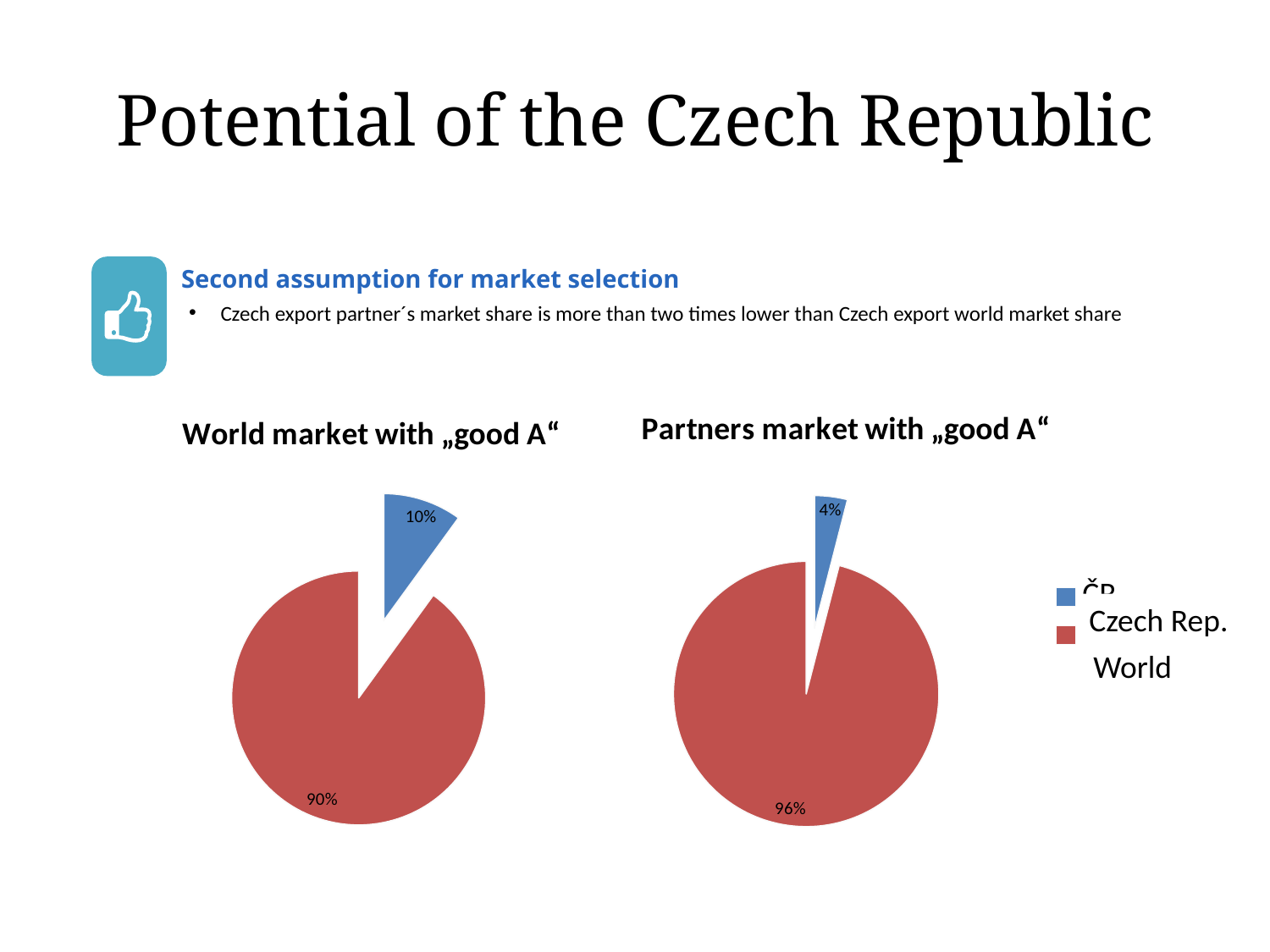
In the "World market with „good A“" chart, which slice is the smallest? Czech Rep. How many slices does the "Partners market with „good A“" pie chart have? 2 How many entries does the legend list for the pie charts? 2 In the "World market with „good A“" chart, what share does the Czech Rep. slice have? 10% What is the difference between the Czech Rep. share in the "World market with „good A“" chart and in the "Partners market with „good A“" chart? 6% What kind of chart is the "World market with „good A“" chart? pie chart In the "Partners market with „good A“" chart, what share does the World slice have? 96% What colour is the World slice in the pie charts? red In the "World market with „good A“" chart, what share does the World slice have? 90% Is the Czech Rep. share larger in the "World market with „good A“" chart or in the "Partners market with „good A“" chart? World market with „good A“ In the "Partners market with „good A“" chart, which slice is the largest? World